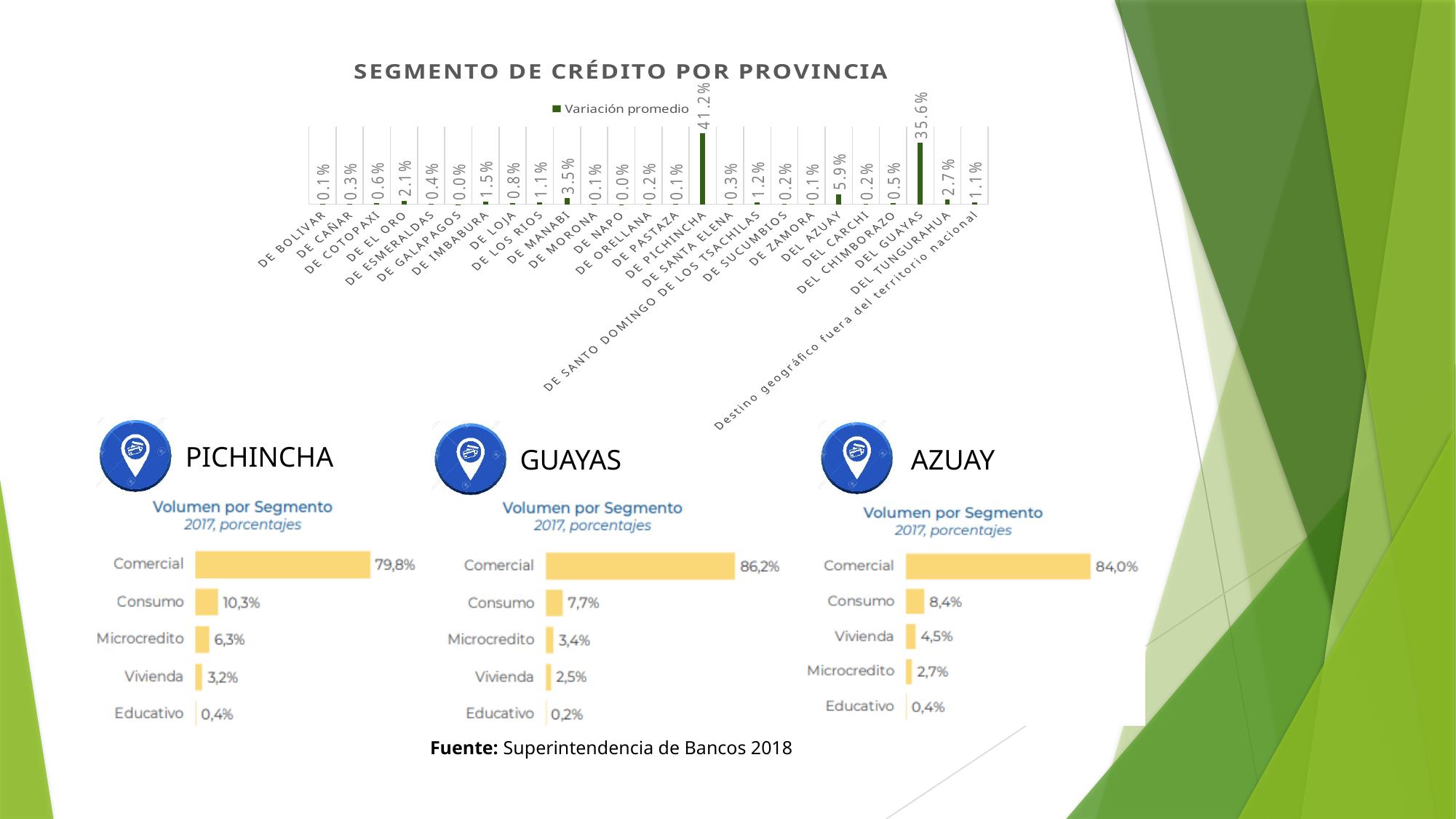
In the chart 'SEGMENTO DE CRÉDITO POR PROVINCIA', what is the value for DEL AZUAY? 5.9% In the chart 'SEGMENTO DE CRÉDITO POR PROVINCIA', what is the name of the series shown in the legend? Variación promedio In the AZUAY 'Volumen por Segmento' chart, how many segments are shown? 5 What kind of chart is 'SEGMENTO DE CRÉDITO POR PROVINCIA'? Bar chart In the AZUAY 'Volumen por Segmento' chart, which segment has the lowest value? Educativo In the chart 'SEGMENTO DE CRÉDITO POR PROVINCIA', how many series does the legend list? 1 In the GUAYAS 'Volumen por Segmento' chart, what is the value for Comercial? 86,2% In the chart 'SEGMENTO DE CRÉDITO POR PROVINCIA', what is the difference between DE PICHINCHA and DEL GUAYAS? 5.6% In the chart 'SEGMENTO DE CRÉDITO POR PROVINCIA', which province has the highest value? DE PICHINCHA In the chart 'SEGMENTO DE CRÉDITO POR PROVINCIA', which is larger, DE MANABI or DEL TUNGURAHUA? DE MANABI In the PICHINCHA 'Volumen por Segmento' chart, what is the value for Consumo? 10,3% In the chart 'SEGMENTO DE CRÉDITO POR PROVINCIA', what is the value for DE PICHINCHA? 41.2%